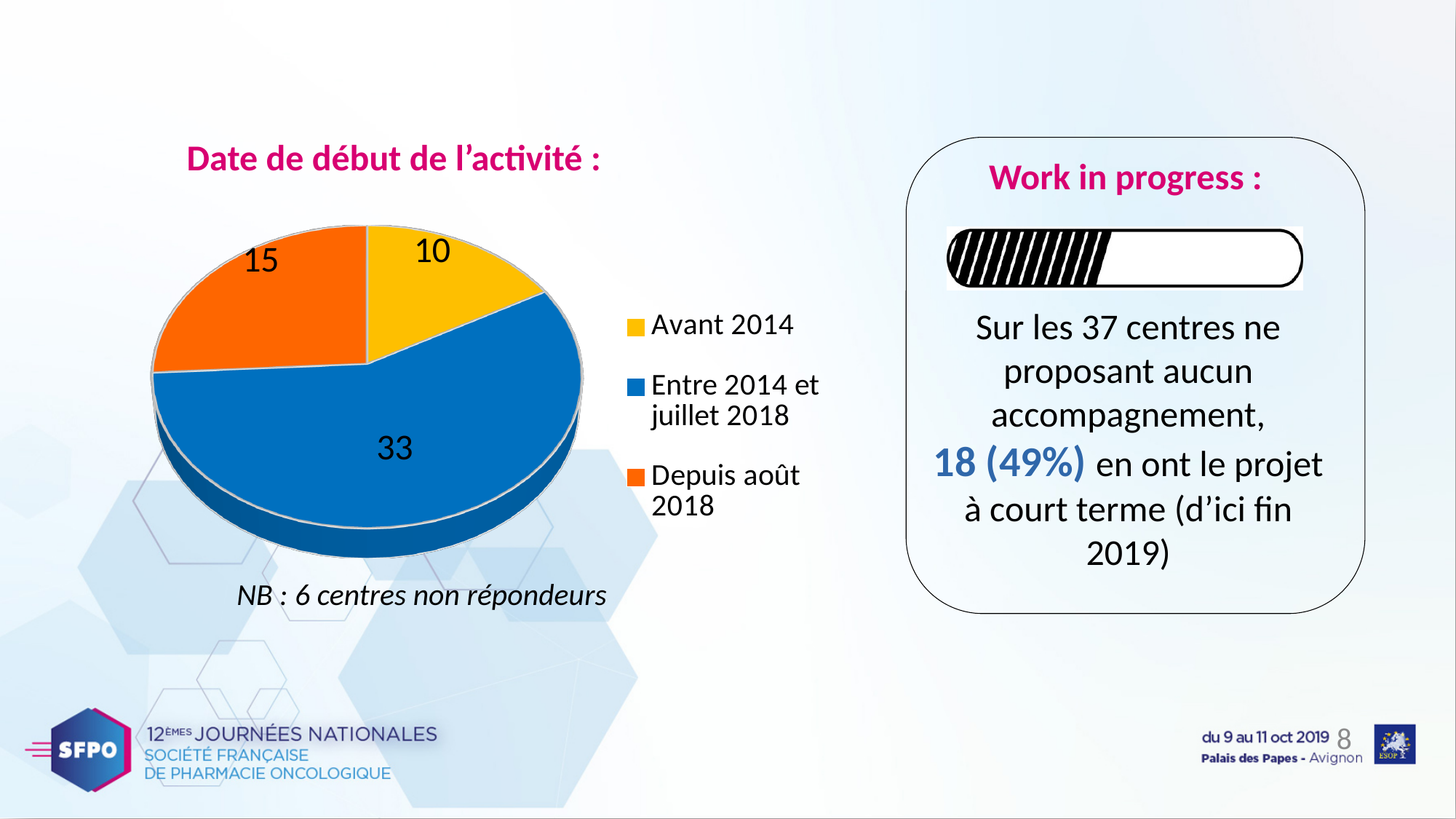
What is the value for "Depuis août 2018" in the pie chart? 15 What is the difference between the values for "Entre 2014 et juillet 2018" and "Depuis août 2018"? 18 What type of chart is shown under the title "Date de début de l'activité"? pie chart What is the value for "Entre 2014 et juillet 2018" in the pie chart? 33 Which is larger: the value for "Depuis août 2018" or the value for "Avant 2014"? Depuis août 2018 Which colour represents "Depuis août 2018" in the pie chart? orange Which category has the largest slice in the pie chart? Entre 2014 et juillet 2018 What is the difference between the values for "Depuis août 2018" and "Avant 2014"? 5 Which category has the smallest slice in the pie chart? Avant 2014 What is the total of all the values shown in the pie chart? 58 How many categories does the pie chart have? 3 How many centres started their activity before 2014 ("Avant 2014")? 10